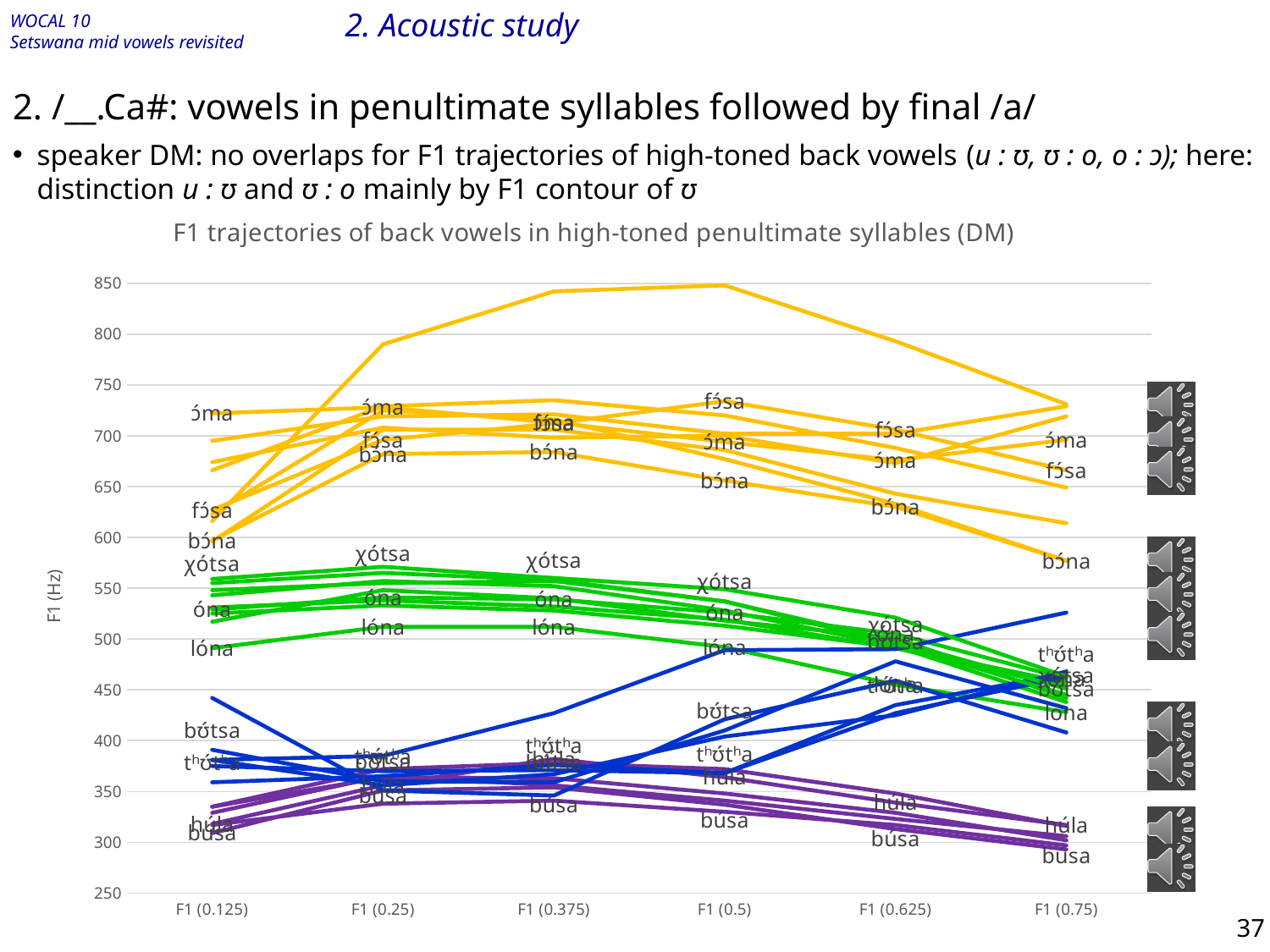
Are the purple lines at F1 (0.75) greater or less than 350? less Do the green lines generally rise or fall between F1 (0.375) and F1 (0.75)? fall Does the topmost yellow line rise or fall between F1 (0.5) and F1 (0.75)? fall What is the label of the vertical axis of the chart? F1 (Hz) Is the value of the lowest blue line at F1 (0.75) greater or less than 450? less What is the title of the chart? F1 trajectories of back vowels in high-toned penultimate syllables (DM) Does the topmost yellow line rise or fall between F1 (0.125) and F1 (0.5)? rise How many time points are shown along the x axis of the chart? 6 Is the value of the topmost yellow line at F1 (0.5) greater or less than 800? greater What kind of chart is shown on the slide? line chart